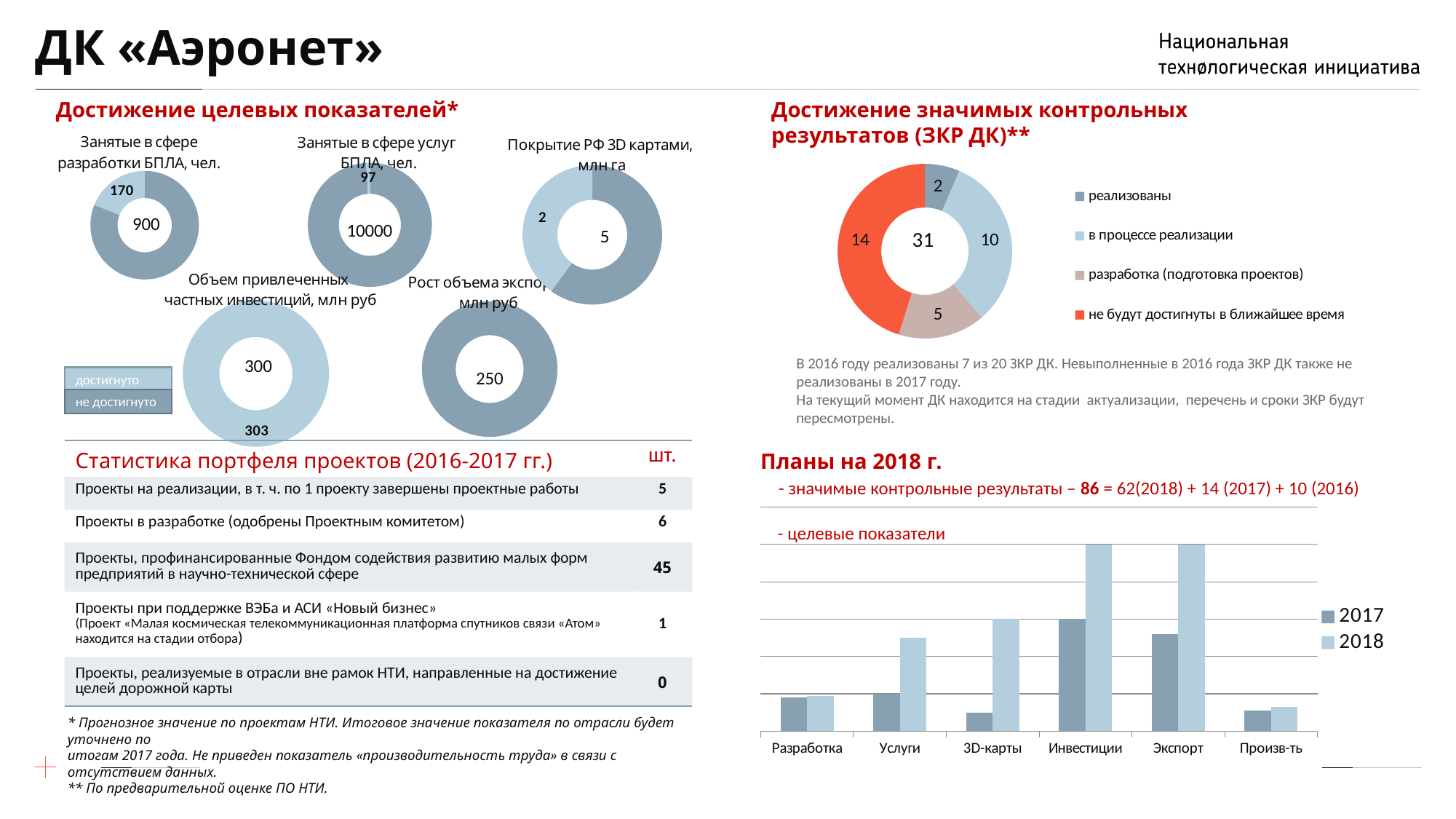
In the donut chart 'Достижение значимых контрольных результатов (ЗКР ДК)', what is the value for 'в процессе реализации'? 10 What kind of chart is shown under 'целевые показатели' in the 'Планы на 2018 г.' section? bar chart In the donut chart 'Достижение значимых контрольных результатов (ЗКР ДК)', what is the difference between 'не будут достигнуты в ближайшее время' and 'в процессе реализации'? 4 In the bar chart under 'целевые показатели', how many categories are shown on the x axis? 6 In the donut chart 'Достижение значимых контрольных результатов (ЗКР ДК)', which category has the smallest slice? реализованы In the donut chart 'Достижение значимых контрольных результатов (ЗКР ДК)', how many categories does the legend list? 4 In the donut chart 'Достижение значимых контрольных результатов (ЗКР ДК)', what is the total of all slices shown in the centre? 31 In the 'Достижение целевых показателей' section, what value is labelled on the achieved segment of the donut 'Покрытие РФ 3D картами, млн га'? 2 In the bar chart under 'целевые показатели', which series has the taller bar for 'Экспорт', 2017 or 2018? 2018 In the 'Достижение целевых показателей' section, what achieved value is labelled on the donut 'Объем привлеченных частных инвестиций, млн руб'? 303 In the donut chart 'Достижение значимых контрольных результатов (ЗКР ДК)', what is the value for 'не будут достигнуты в ближайшее время'? 14 In the donut chart 'Достижение значимых контрольных результатов (ЗКР ДК)', which category has the largest slice? не будут достигнуты в ближайшее время